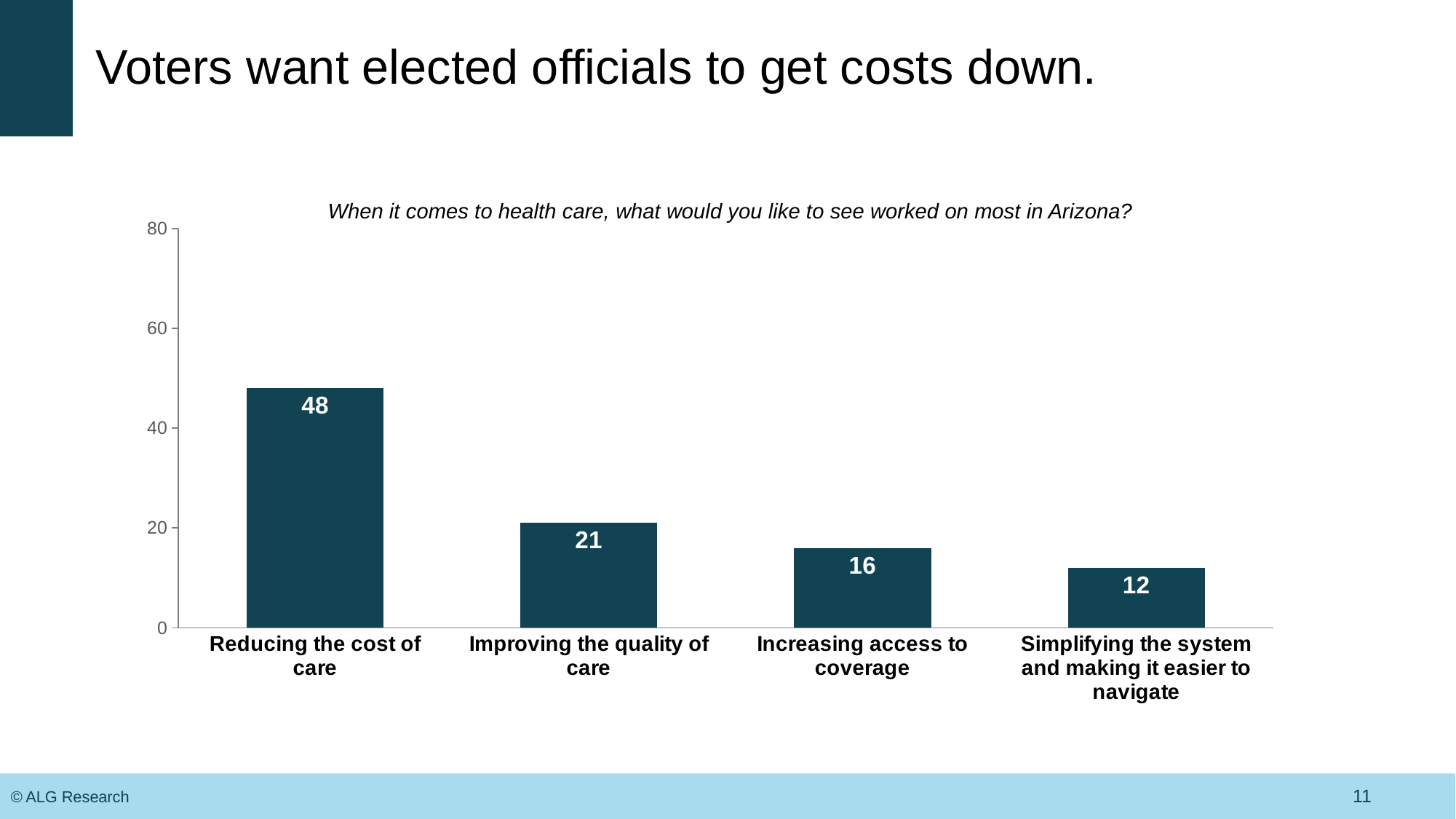
What is the value for "Increasing access to coverage"? 16 What kind of chart is shown on the slide? Bar chart How many categories are shown in the chart? 4 What is the value for "Simplifying the system and making it easier to navigate"? 12 What is the difference between the values for "Reducing the cost of care" and "Improving the quality of care"? 27 What is the title of the chart? When it comes to health care, what would you like to see worked on most in Arizona? What is the value for "Reducing the cost of care"? 48 Which category has the lowest value? Simplifying the system and making it easier to navigate Which category has the highest value? Reducing the cost of care What is the value for "Improving the quality of care"? 21 Which is larger, the value for "Increasing access to coverage" or the value for "Simplifying the system and making it easier to navigate"? Increasing access to coverage Is the value for "Reducing the cost of care" greater or less than 40? greater